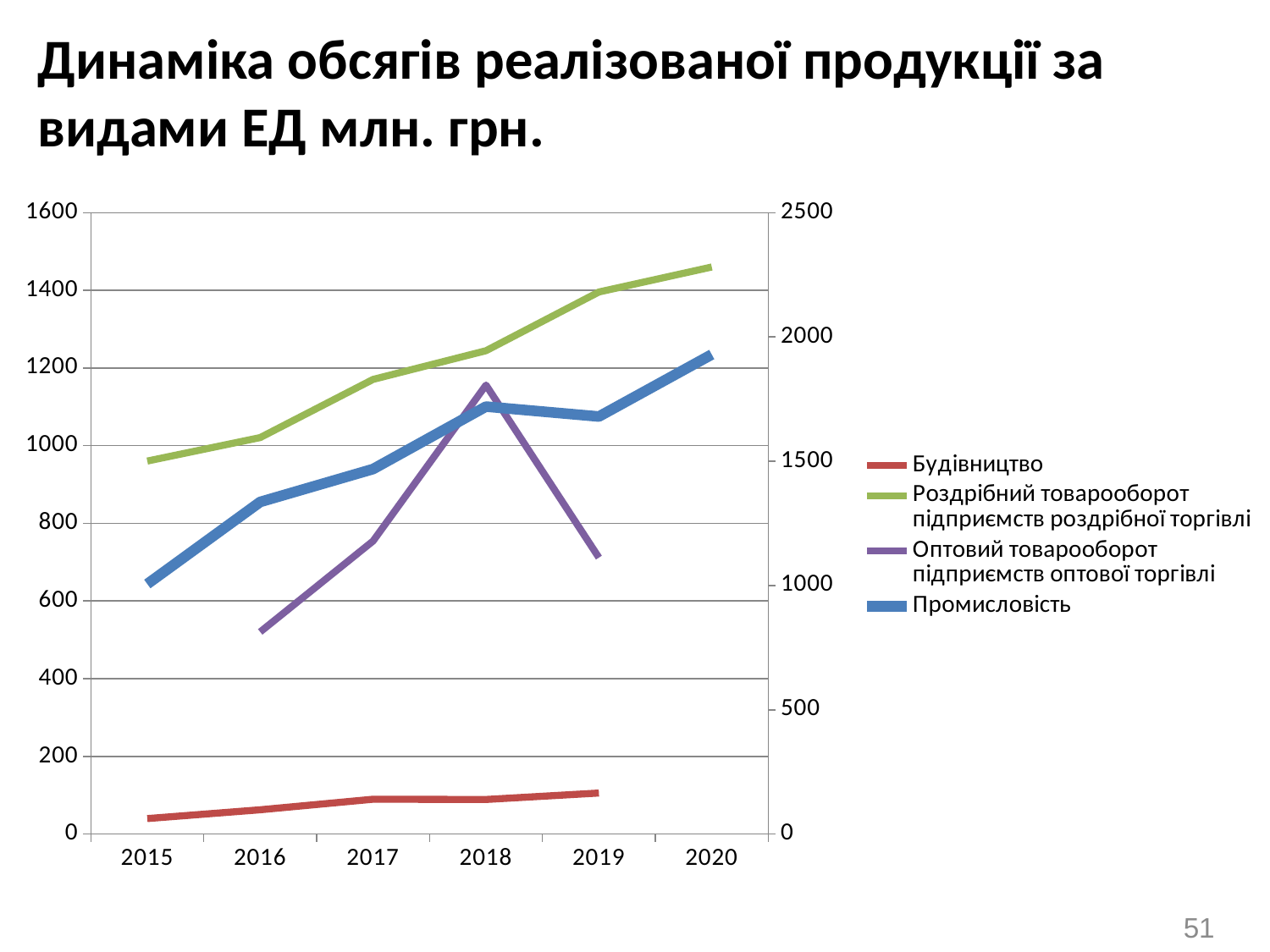
In 2017, which is larger: Роздрібний товарооборот підприємств роздрібної торгівлі or Будівництво? Роздрібний товарооборот підприємств роздрібної торгівлі How many series does the legend list? 4 What is the title of the slide? Динаміка обсягів реалізованої продукції за видами ЕД млн. грн. In which year is the Будівництво line at its lowest? 2015 Is the value for Будівництво in 2019 greater or less than 500? less Is the value for Роздрібний товарооборот підприємств роздрібної торгівлі in 2020 greater or less than 1000? greater In which year does the Оптовий товарооборот підприємств оптової торгівлі line reach its highest value? 2018 How many years are shown on the x axis? 6 What kind of chart is shown on the slide? line chart In which year does the Роздрібний товарооборот підприємств роздрібної торгівлі line reach its highest value? 2020 What colour is the Промисловість line in the legend? blue Does the Роздрібний товарооборот підприємств роздрібної торгівлі line rise or fall from 2015 to 2020? rise